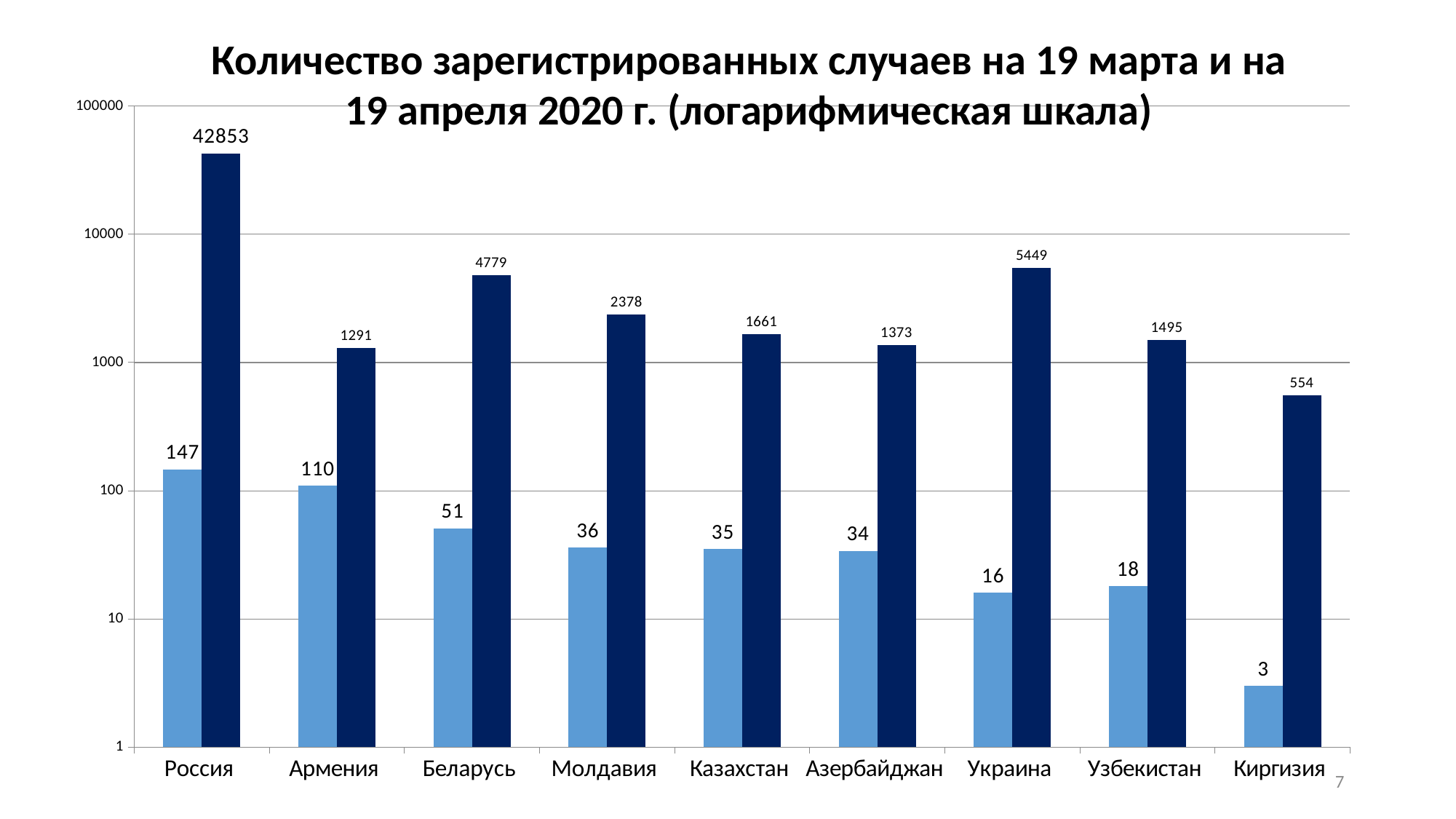
What is the difference between the dark blue and light blue bars for Украина? 5433 Which country has the highest dark blue bar? Россия What is the value of the light blue bar for Узбекистан? 18 Which country has the lowest light blue bar? Киргизия Which has the larger dark blue bar, Беларусь or Украина? Украина What kind of chart is shown on the slide? bar chart How many countries are shown on the x axis? 9 What is the value of the light blue bar for Киргизия? 3 Is the value of the dark blue bar for Киргизия greater or less than 1000? less What is the value of the dark blue bar for Россия? 42853 Which country has the lowest dark blue bar? Киргизия What is the difference between the dark blue bars for Казахстан and Азербайджан? 288